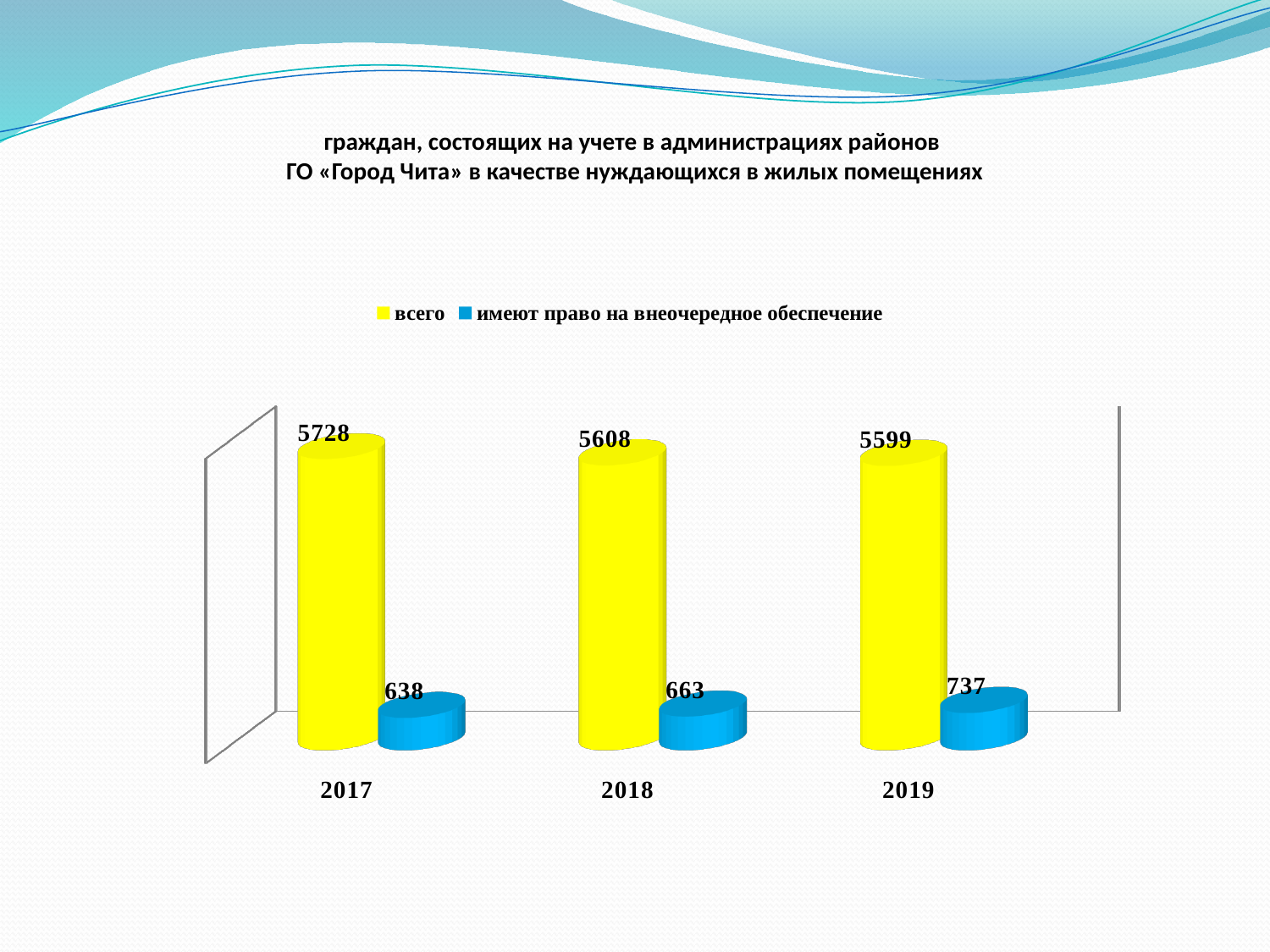
What is the value of "всего" for 2017? 5728 How many years are shown on the x axis? 3 What is the difference between the "всего" values for 2017 and 2019? 129 Which is larger: the "всего" value for 2018 or for 2019? 2018 What is the value of "имеют право на внеочередное обеспечение" for 2019? 737 What is the difference between the "имеют право на внеочередное обеспечение" values for 2019 and 2018? 74 What is the value of "всего" for 2019? 5599 How many series does the legend list? 2 Does the "имеют право на внеочередное обеспечение" series rise or fall from 2017 to 2019? Rises In which year is the "имеют право на внеочередное обеспечение" value lowest? 2017 In which year is the "всего" value highest? 2017 What kind of chart is shown on the slide? Bar chart